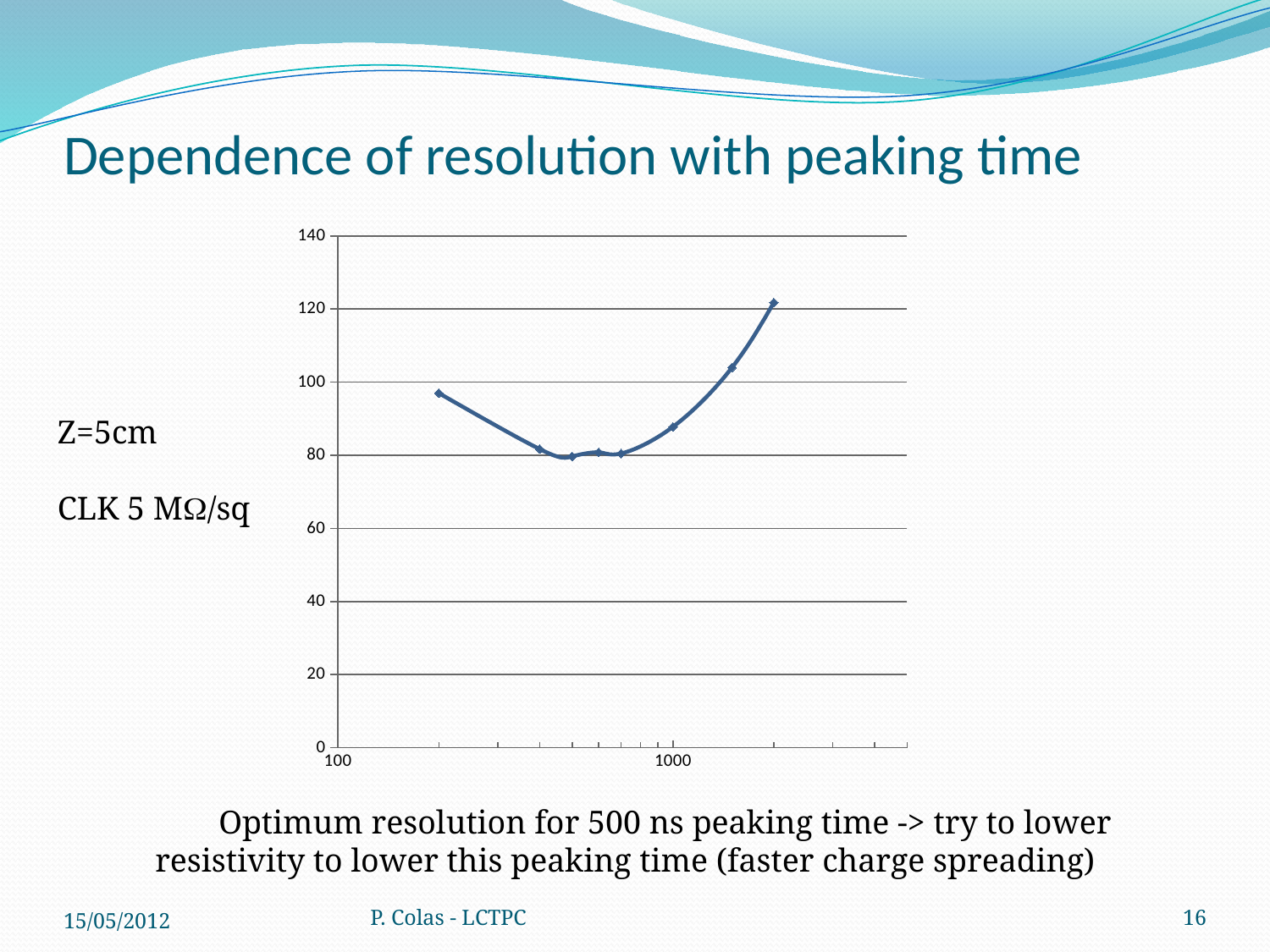
Does the plotted value rise or fall from the point at 1000 on the x axis to the rightmost point? rise Is the value of the rightmost point greater or less than 100? greater What are the two labelled tick values on the x axis? 100 and 1000 Which point has the highest value, the leftmost point or the rightmost point? the rightmost point Is the value of the leftmost point greater or less than 80? greater What kind of chart is shown on the slide? line chart How many data points are plotted on the chart? 8 Is the value of the leftmost point greater or less than 100? less Does the plotted value rise or fall from the leftmost point to the lowest point of the curve? fall What is the highest value shown on the y axis? 140